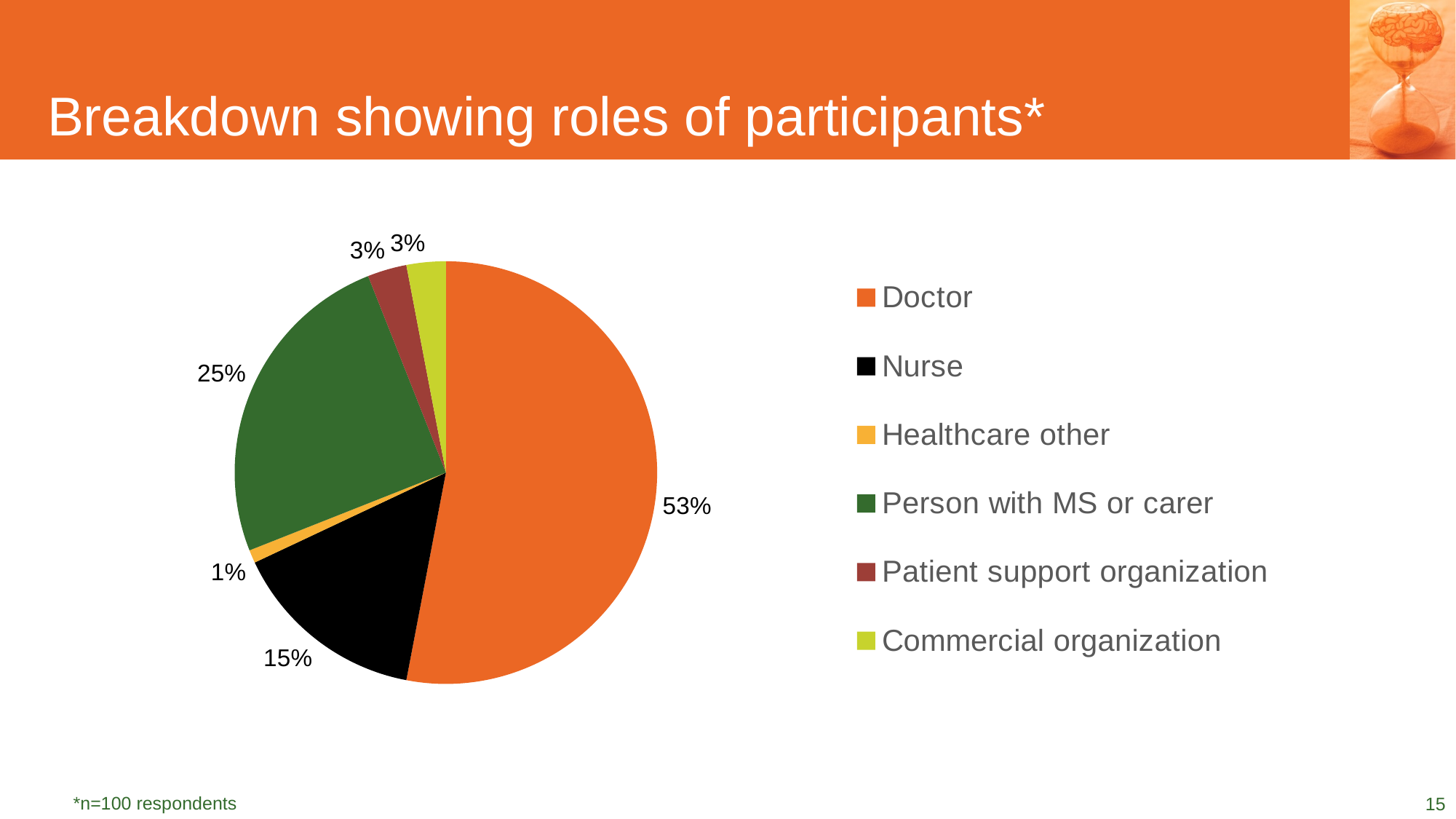
What share of participants are from a Patient support organization? 3% What is the difference in percentage points between the Doctor share and the Nurse share? 38 Which is larger, the share for Nurse or the share for Person with MS or carer? Person with MS or carer Which role has the largest share of participants? Doctor What colour represents Commercial organization in the chart? Yellow-green What share of participants are Persons with MS or carers? 25% What share of participants fall under Healthcare other? 1% What type of chart is shown on the slide? Pie chart Which role has the smallest share of participants? Healthcare other What share of participants are Nurses? 15% What share of participants are Doctors? 53% How many roles are shown in the pie chart? 6